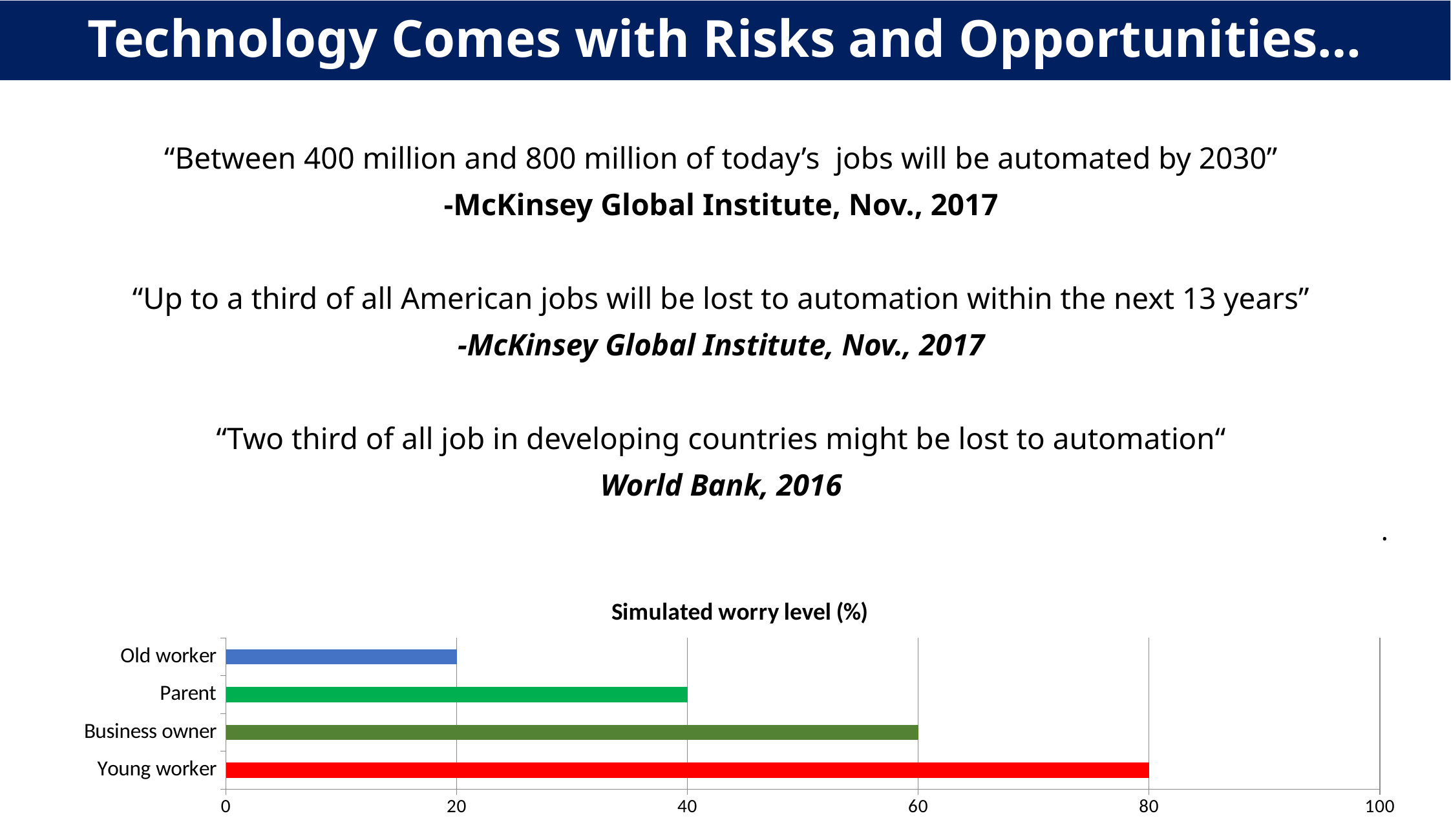
What is the simulated worry level for Parent? 40 What is the title of the chart? Simulated worry level (%) Which category has the highest simulated worry level? Young worker What kind of chart is shown on the slide? bar chart Which category has the lowest simulated worry level? Old worker What is the simulated worry level for Old worker? 20 Which has a higher simulated worry level, Parent or Business owner? Business owner What colour is the bar for Young worker? red What is the simulated worry level for Business owner? 60 How many categories are plotted in the chart? 4 What is the simulated worry level for Young worker? 80 What is the difference between the simulated worry level of Young worker and Old worker? 60